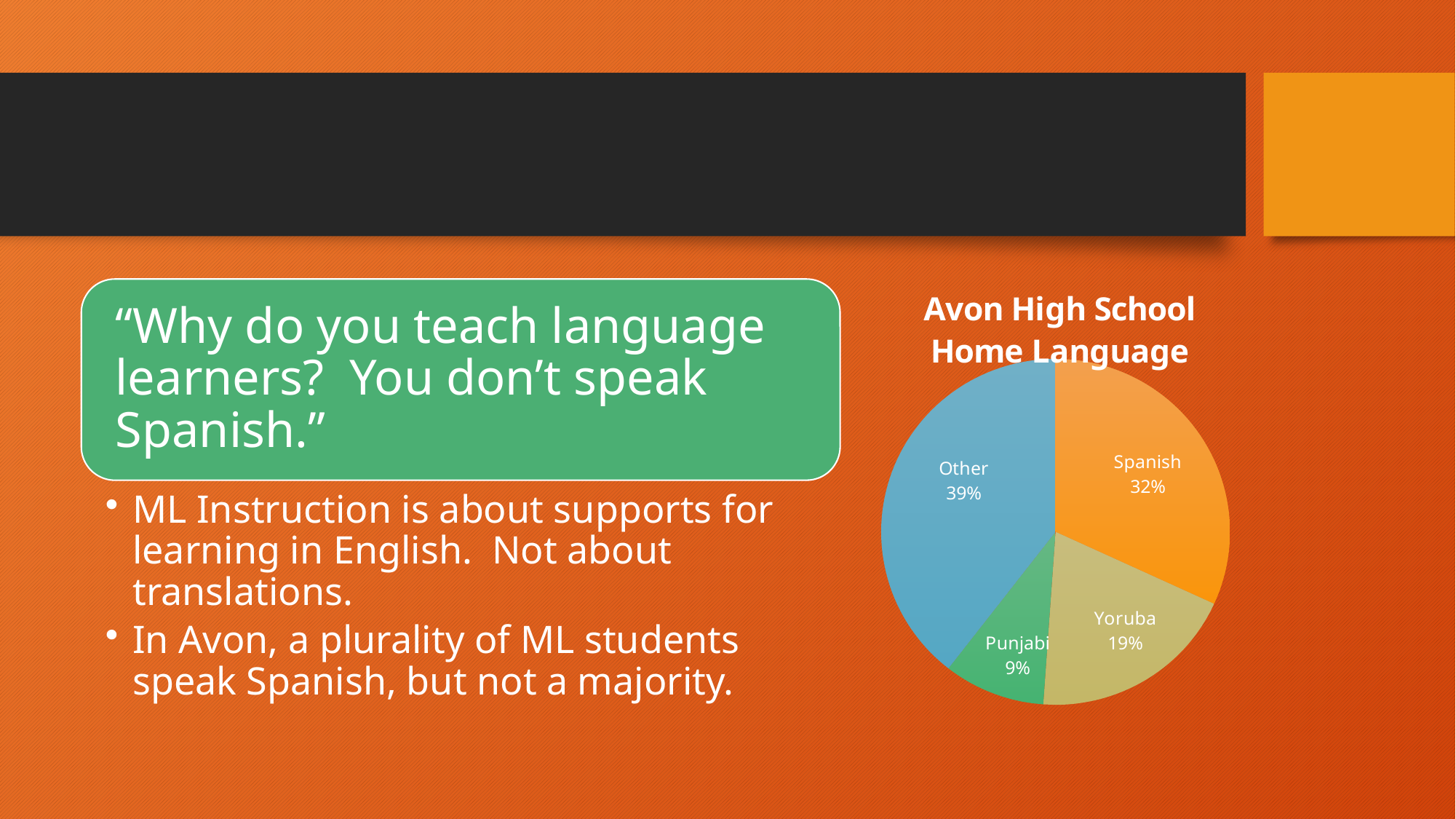
What is the difference in percentage points between the Spanish and Yoruba slices? 13 Which slice of the pie is the smallest? Punjabi Which slice is larger, Spanish or Other? Other What colour is the Other slice? blue What is the title of the chart? Avon High School Home Language How many slices does the pie chart have? 4 What percentage of the pie is Yoruba? 19% What percentage of the pie is Punjabi? 9% Which slice of the pie is the largest? Other What percentage of the pie is Other? 39% What percentage of the pie is Spanish? 32% What kind of chart is shown on the slide? pie chart